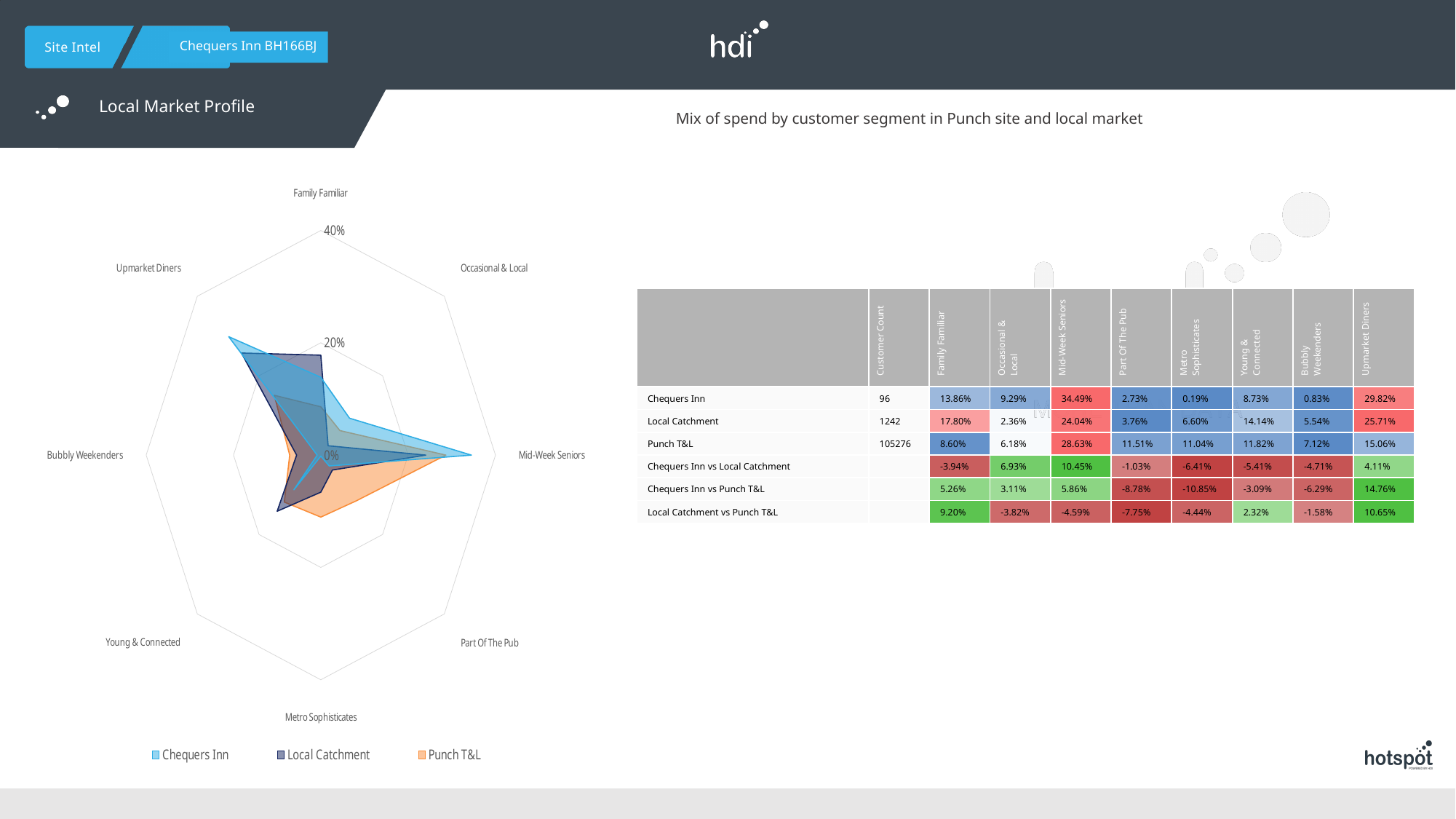
How many customer segments (axes) does the radar chart have? 8 What is the difference between Chequers Inn and Punch T&L in the Mid-Week Seniors segment? 5.86% How many series does the radar chart's legend list? 3 What kind of chart is shown on the left of the slide? Radar chart Is the Punch T&L value for Family Familiar greater or less than 20%? less What colour represents Punch T&L in the radar chart legend? Orange What is the share of spend for Chequers Inn in the Mid-Week Seniors segment? 34.49% Which customer segment has the highest share of spend for Chequers Inn? Mid-Week Seniors Which customer segment has the lowest share of spend for Chequers Inn? Metro Sophisticates What is the share of spend for Punch T&L in the Part Of The Pub segment? 11.51% For Upmarket Diners, which is larger: Chequers Inn or Local Catchment? Chequers Inn Is the Chequers Inn value for Mid-Week Seniors greater or less than 20%? greater